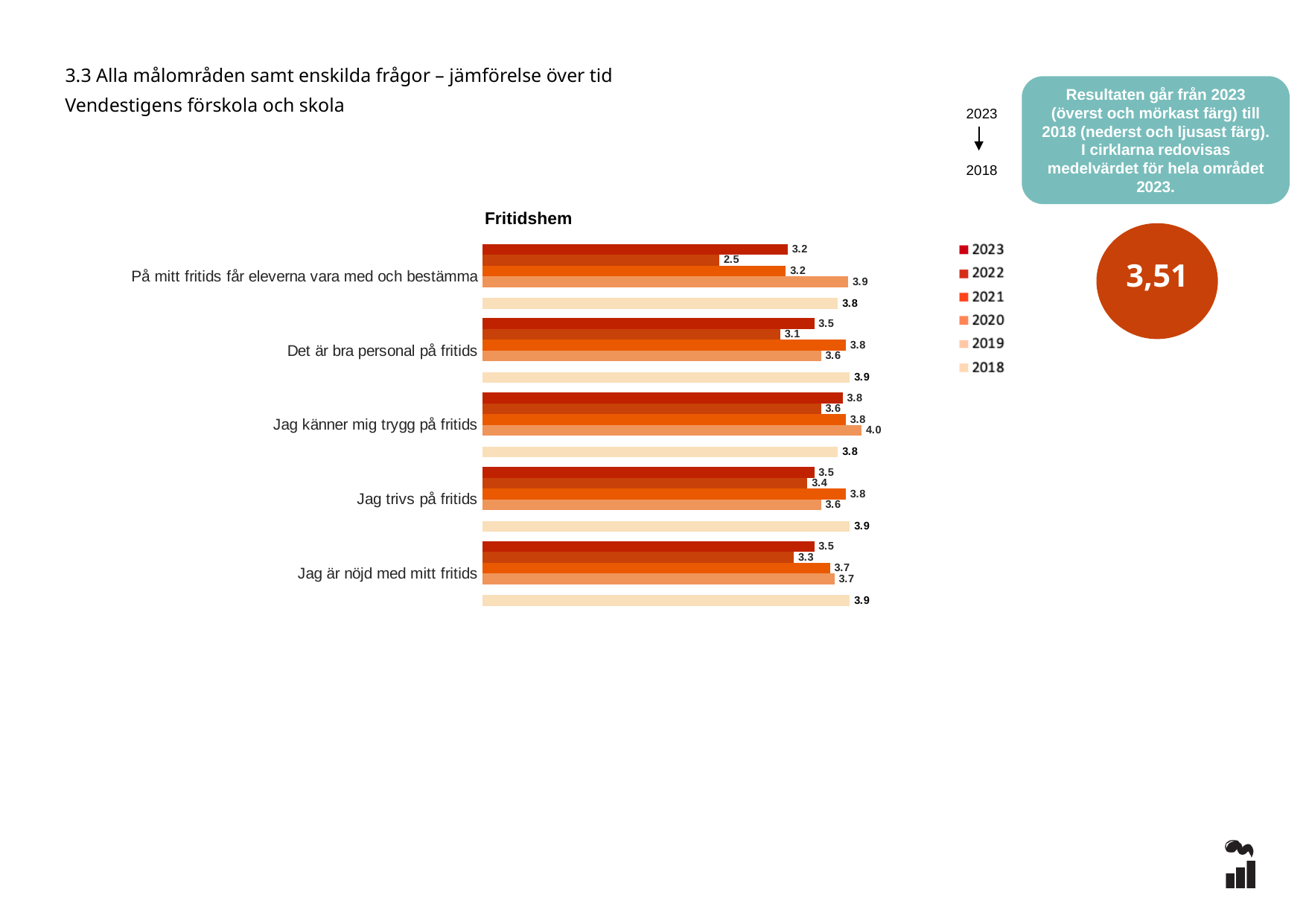
Which is larger for "Det är bra personal på fritids": the 2021 value or the 2022 value? 2021 What is the difference between the 2023 and 2022 values for "På mitt fritids får eleverna vara med och bestämma"? 0.7 How many categories (questions) are shown in the chart? 5 Which category has the highest 2020 value? Jag känner mig trygg på fritids Which category has the lowest 2022 value? På mitt fritids får eleverna vara med och bestämma What type of chart is shown on the slide? Bar chart What is the title of the chart? Fritidshem How many series does the legend list? 6 What is the 2023 value for "Jag känner mig trygg på fritids"? 3.8 What is the 2020 value for "Jag är nöjd med mitt fritids"? 3.7 What is the 2022 value for "På mitt fritids får eleverna vara med och bestämma"? 2.5 What is the 2018 value for "Det är bra personal på fritids"? 3.9